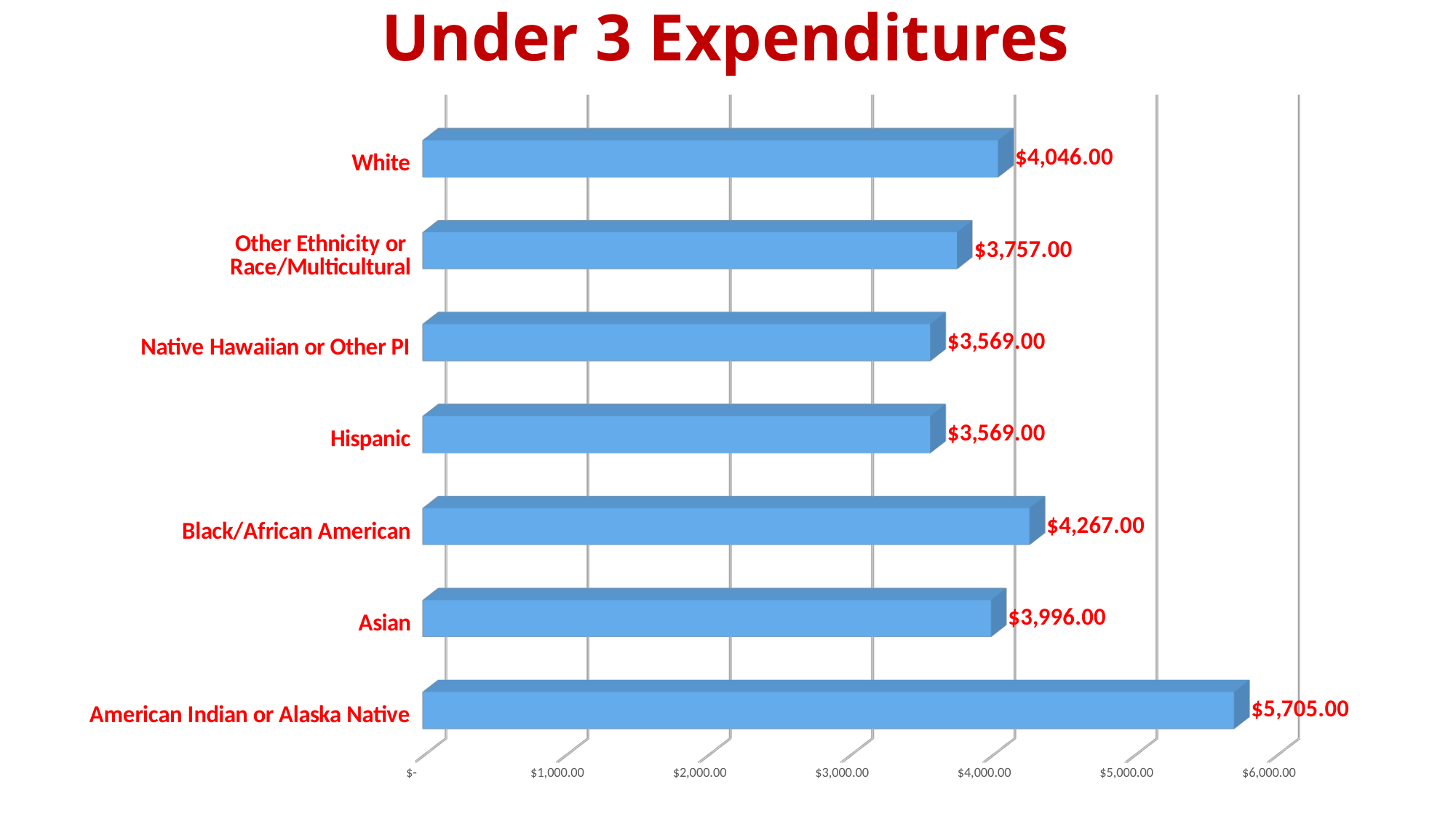
What kind of chart is shown on the slide? Bar chart What is the Under 3 expenditure value for White? $4,046.00 Is the value for Asian greater or less than $4,000.00? less What is the title of the chart? Under 3 Expenditures What is the difference between the expenditure for American Indian or Alaska Native and for White? $1,659.00 What is the Under 3 expenditure value for Other Ethnicity or Race/Multicultural? $3,757.00 How many categories are shown in the chart? 7 What is the Under 3 expenditure value for Asian? $3,996.00 Which is larger, the expenditure for White or for Other Ethnicity or Race/Multicultural? White What is the Under 3 expenditure value for Black/African American? $4,267.00 Which category has the highest Under 3 expenditure? American Indian or Alaska Native What is the difference between the expenditure for Black/African American and for Asian? $271.00